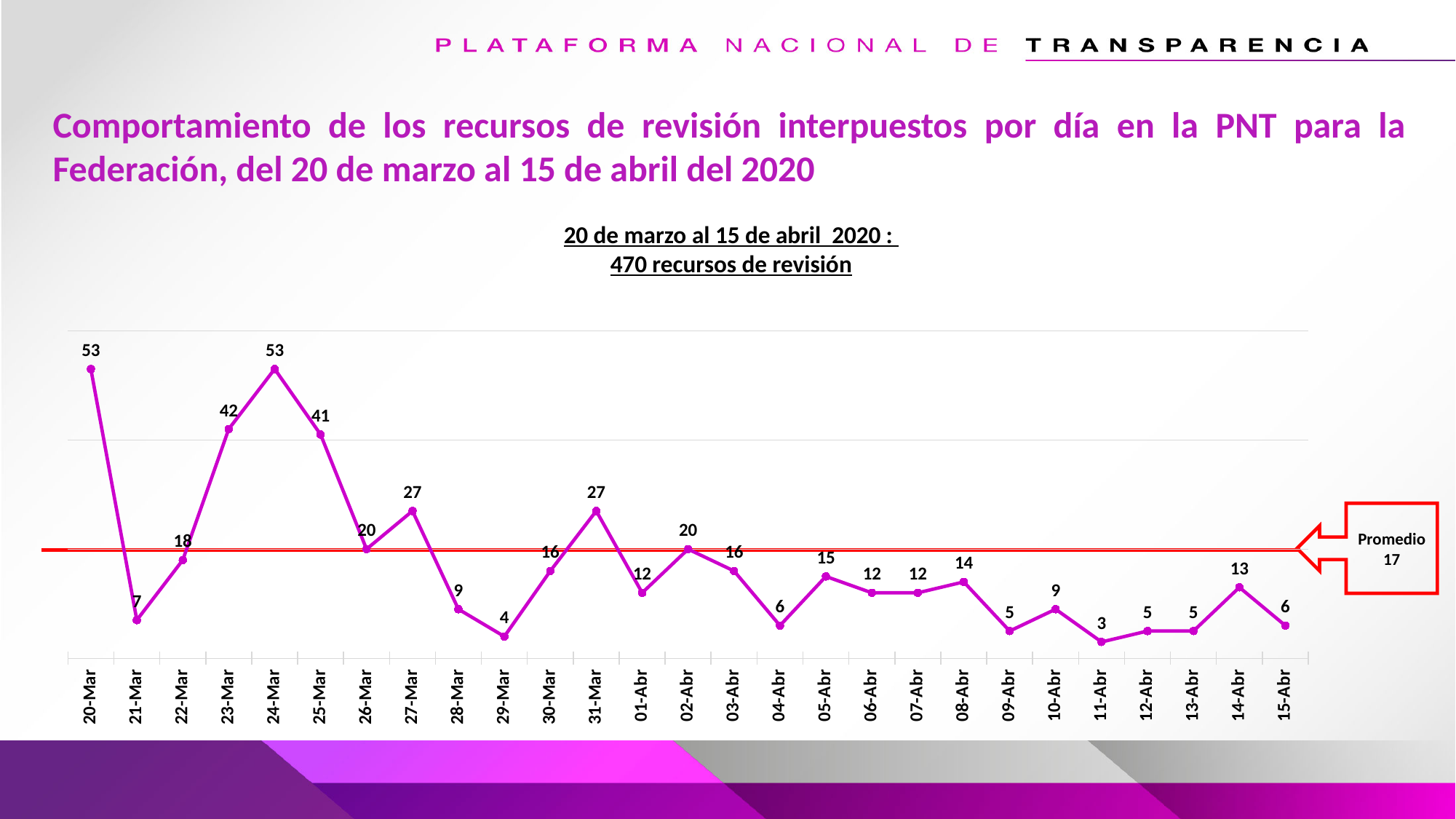
What is the difference between the values for 31-Mar and 01-Abr? 15 What kind of chart is shown on the slide? line chart What is the value for 23-Mar? 42 Which is larger, the value for 27-Mar or the value for 02-Abr? 27-Mar What is the value for 08-Abr? 14 How many dates are plotted on the chart? 27 Which date has the lowest value? 11-Abr Do the values generally rise or fall from 02-Abr to 15-Abr? fall What is the highest value plotted on the chart? 53 What is the value for 29-Mar? 4 What is the difference between the values for 24-Mar and 25-Mar? 12 What average value (Promedio) is indicated by the red line on the chart? 17